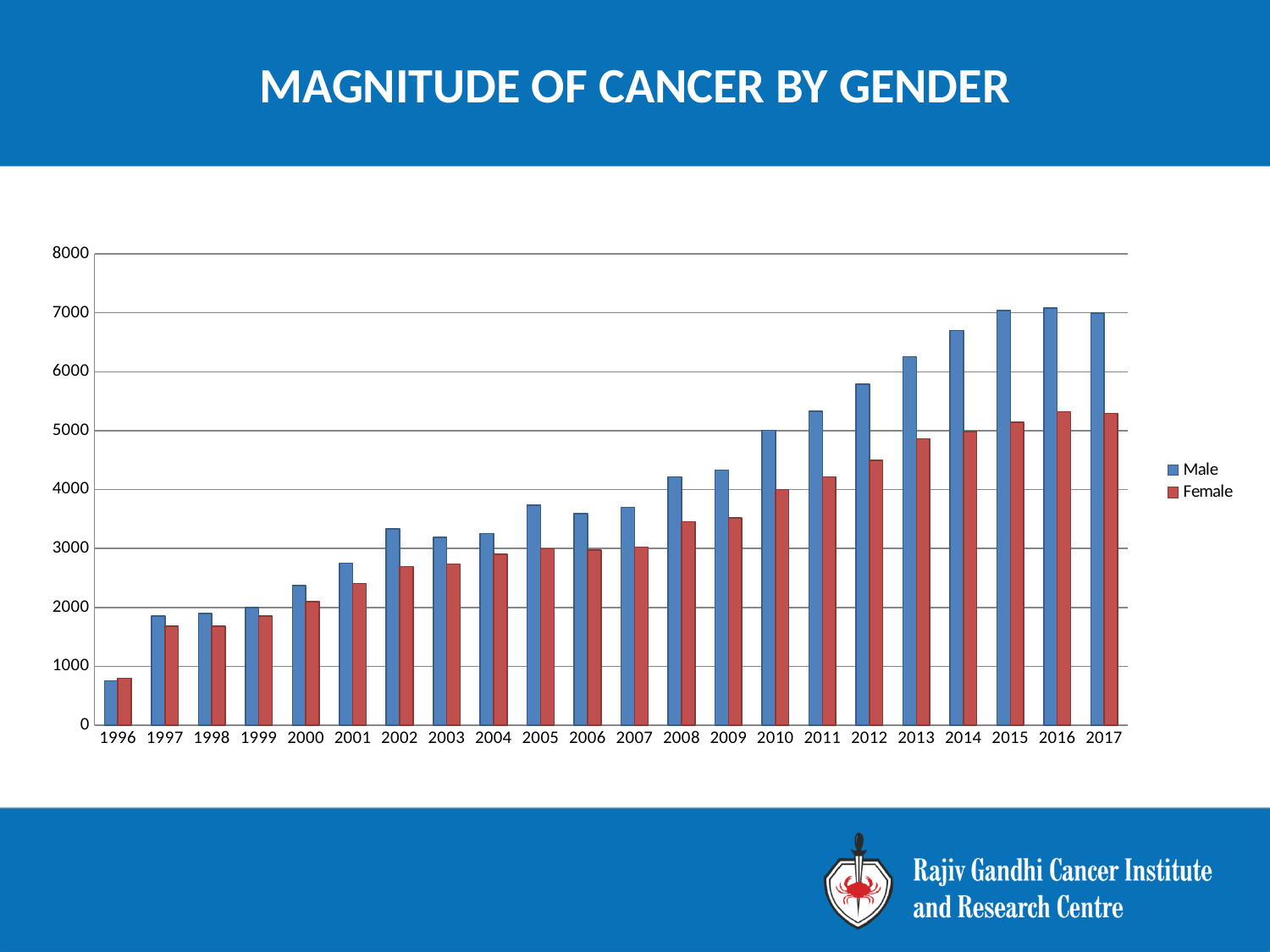
What is the title of the chart? MAGNITUDE OF CANCER BY GENDER In 2012, which is larger, the Male value or the Female value? Male Is the Male value for 2012 greater or less than 5000? greater Which year has the lowest Male value? 1996 Is the Female value for 2008 greater or less than 3000? greater Is the Female value for 1997 greater or less than 2000? less Do the Male values generally rise or fall from 1996 to 2017? rise What kind of chart is shown on the slide? bar chart How many years are shown on the x axis? 22 How many series does the legend list? 2 Which year has the lowest Female value? 1996